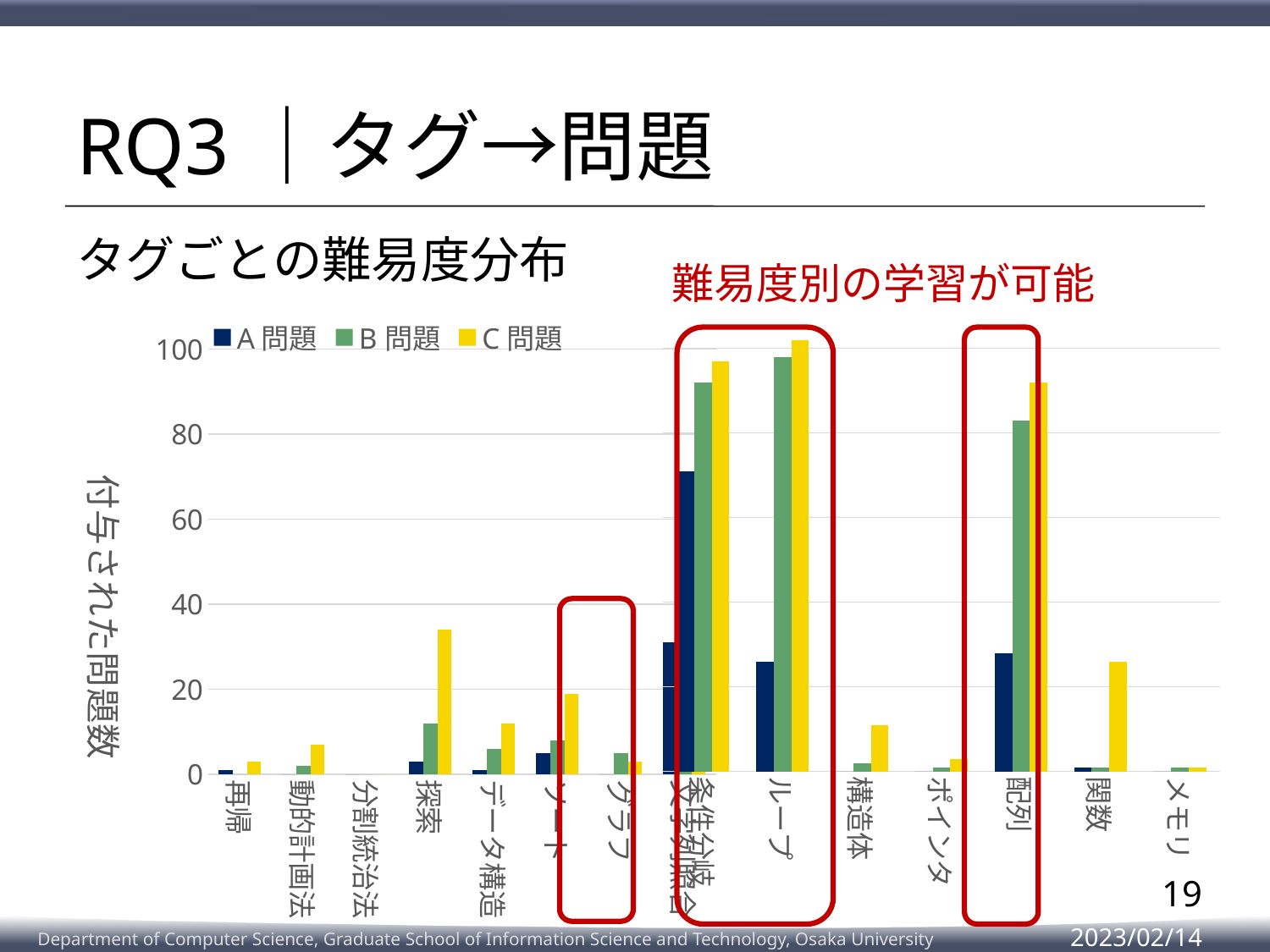
Is the value for C 問題 in 探索 greater or less than 40? less Is the value for B 問題 in 配列 greater or less than 60? greater Which category has the highest value for C 問題? ループ What is the title of the vertical axis of the chart? 付与された問題数 Which is larger: the B 問題 value for 配列 or the B 問題 value for 探索? 配列 Is the value for A 問題 in ループ greater or less than 40? less How many series does the legend list? 3 What kind of chart is shown on the slide? bar chart Which is larger: the C 問題 value for 関数 or the C 問題 value for 構造体? 関数